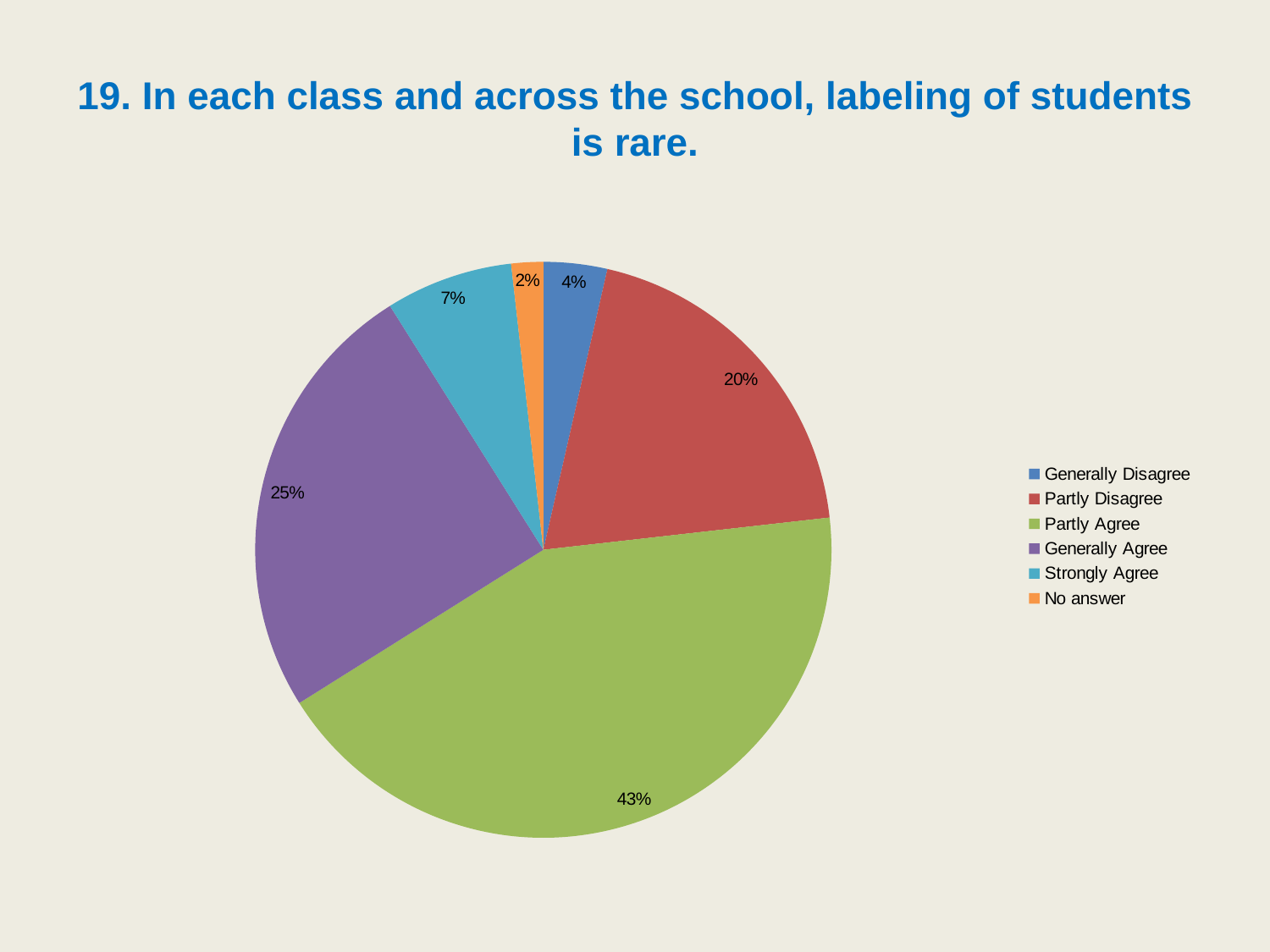
Which response category has the largest share of the pie? Partly Agree What colour is the Generally Agree slice? purple What percentage of respondents chose Partly Agree? 43% What kind of chart is shown on the slide? pie chart What percentage of respondents chose Partly Disagree? 20% What is the difference in percentage points between Partly Agree and Generally Agree? 18 What percentage of respondents gave No answer? 2% Which response category has the smallest share of the pie? No answer Which is larger, the share for Partly Disagree or the share for Strongly Agree? Partly Disagree How many categories does the legend list? 6 What percentage of respondents chose Strongly Agree? 7% What percentage of respondents chose Generally Agree? 25%